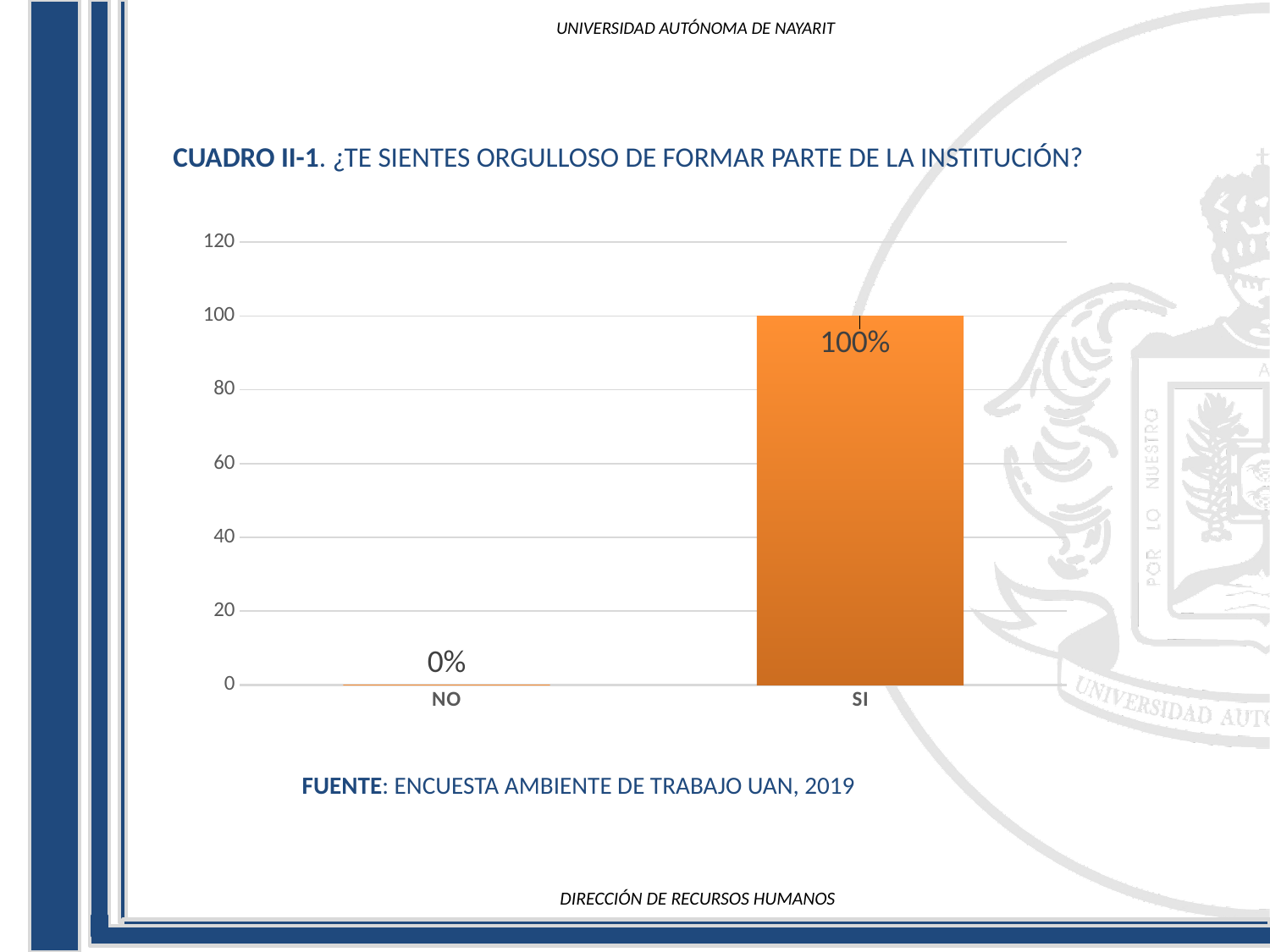
What is the difference between the values for SI and NO? 100% How many categories are shown on the x axis? 2 What is the value for SI? 100% Is the value for SI greater or less than 80? greater What source is cited below the chart? ENCUESTA AMBIENTE DE TRABAJO UAN, 2019 Which is larger, the value for SI or the value for NO? SI What kind of chart is shown on the slide? bar chart Which category has the lowest value? NO Is the value for NO greater or less than 20? less What is the value for NO? 0% Which category has the highest value? SI What is the highest tick value shown on the vertical axis? 120